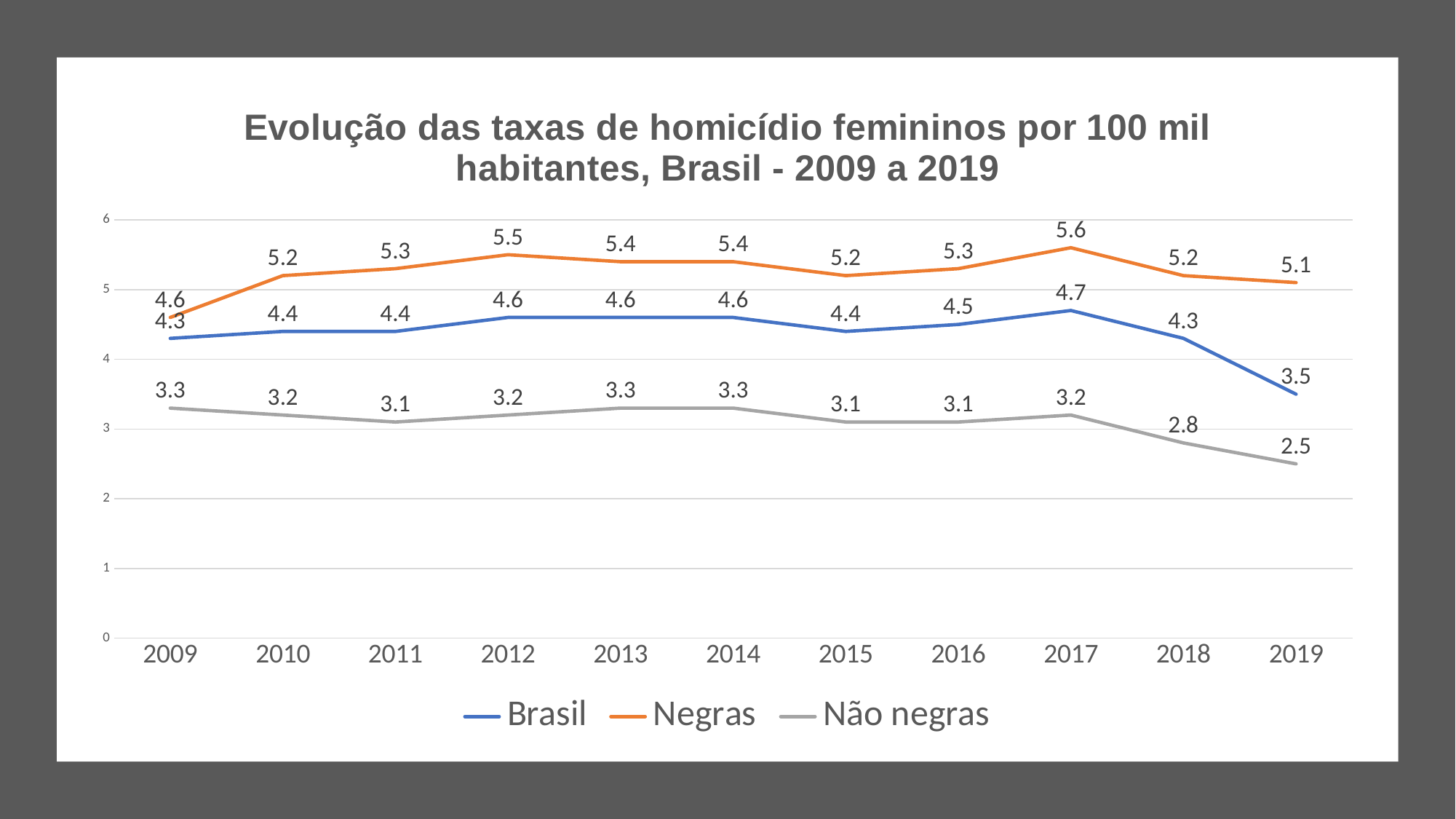
Which is larger in 2012: the value for Negras or the value for Brasil? Negras Does the Brasil series rise or fall from 2017 to 2019? fall What is the value for Negras in 2017? 5.6 In which year is the Não negras series lowest? 2019 How many years are shown on the x axis? 11 What is the difference between the Negras and Não negras values in 2019? 2.6 In which year is the Negras series highest? 2017 Is the value for Não negras in 2019 greater or less than 3? less What kind of chart is this? line chart How many series does the legend list? 3 What is the value for Brasil in 2019? 3.5 What is the value for Não negras in 2018? 2.8